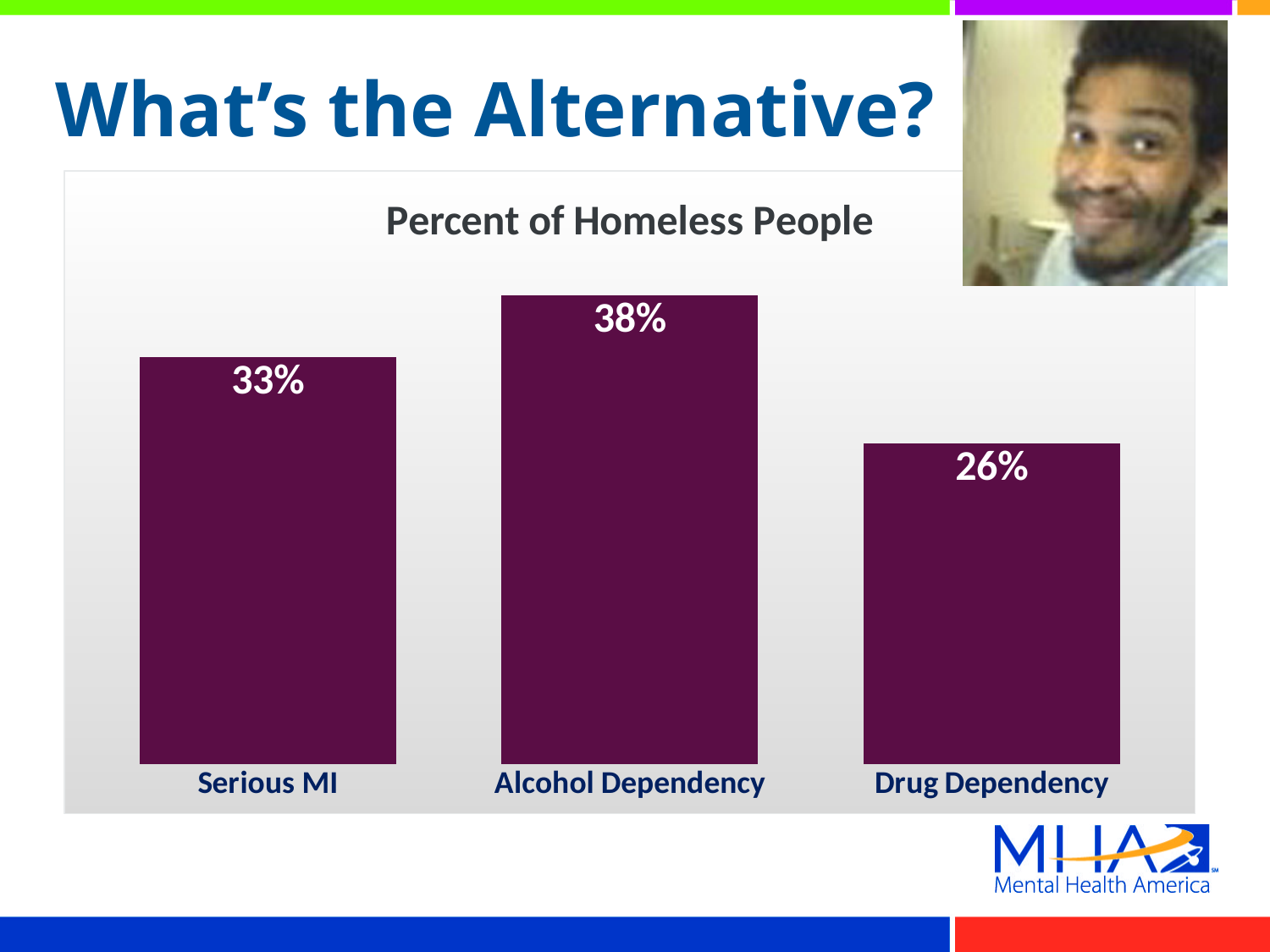
How many categories are shown in the chart? 3 What is the title of the chart? Percent of Homeless People Which category has the lowest value? Drug Dependency What colour are the bars in the chart? Dark purple What is the value for Serious MI? 33% Which category has the highest value? Alcohol Dependency What is the value for Drug Dependency? 26% What kind of chart is shown on the slide? Bar chart What is the difference between the values for Alcohol Dependency and Drug Dependency? 12% What is the difference between the values for Alcohol Dependency and Serious MI? 5% Which is larger, the value for Serious MI or the value for Drug Dependency? Serious MI What is the value for Alcohol Dependency? 38%